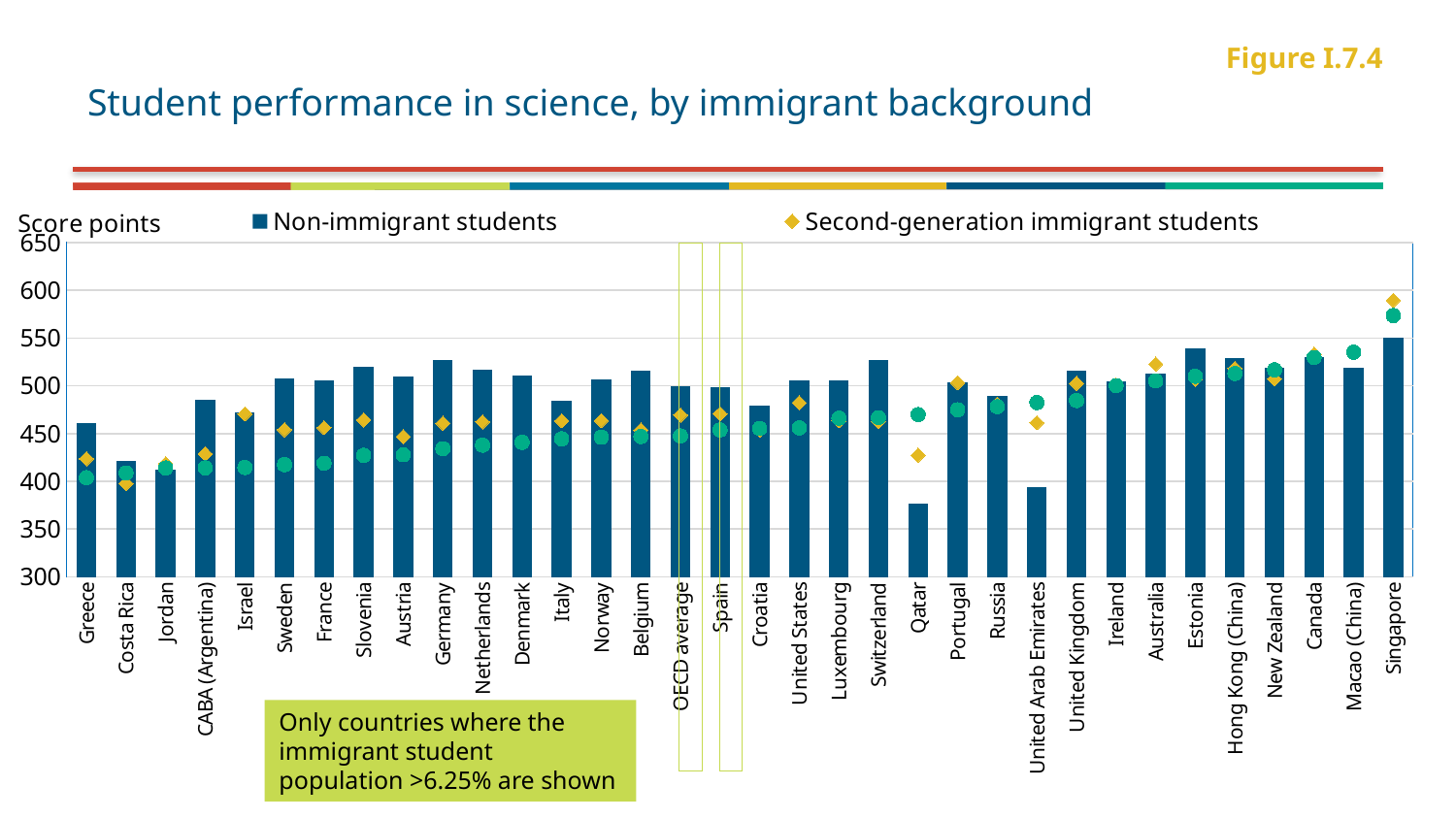
What kind of chart is shown on the slide? Bar chart Is the non-immigrant students value for Costa Rica greater or less than 450? less Is the second-generation immigrant students value for Singapore greater or less than 550? greater Which has the higher non-immigrant students bar, Jordan or Qatar? Jordan What is the label on the vertical axis? Score points Is the non-immigrant students value for Qatar greater or less than 400? less How many series does the chart legend list? 2 What is the title of the chart? Student performance in science, by immigrant background Which country has the highest bar for non-immigrant students? Singapore Which country has the lowest bar for non-immigrant students? Qatar How many countries or economies (including the OECD average) are shown along the x axis? 34